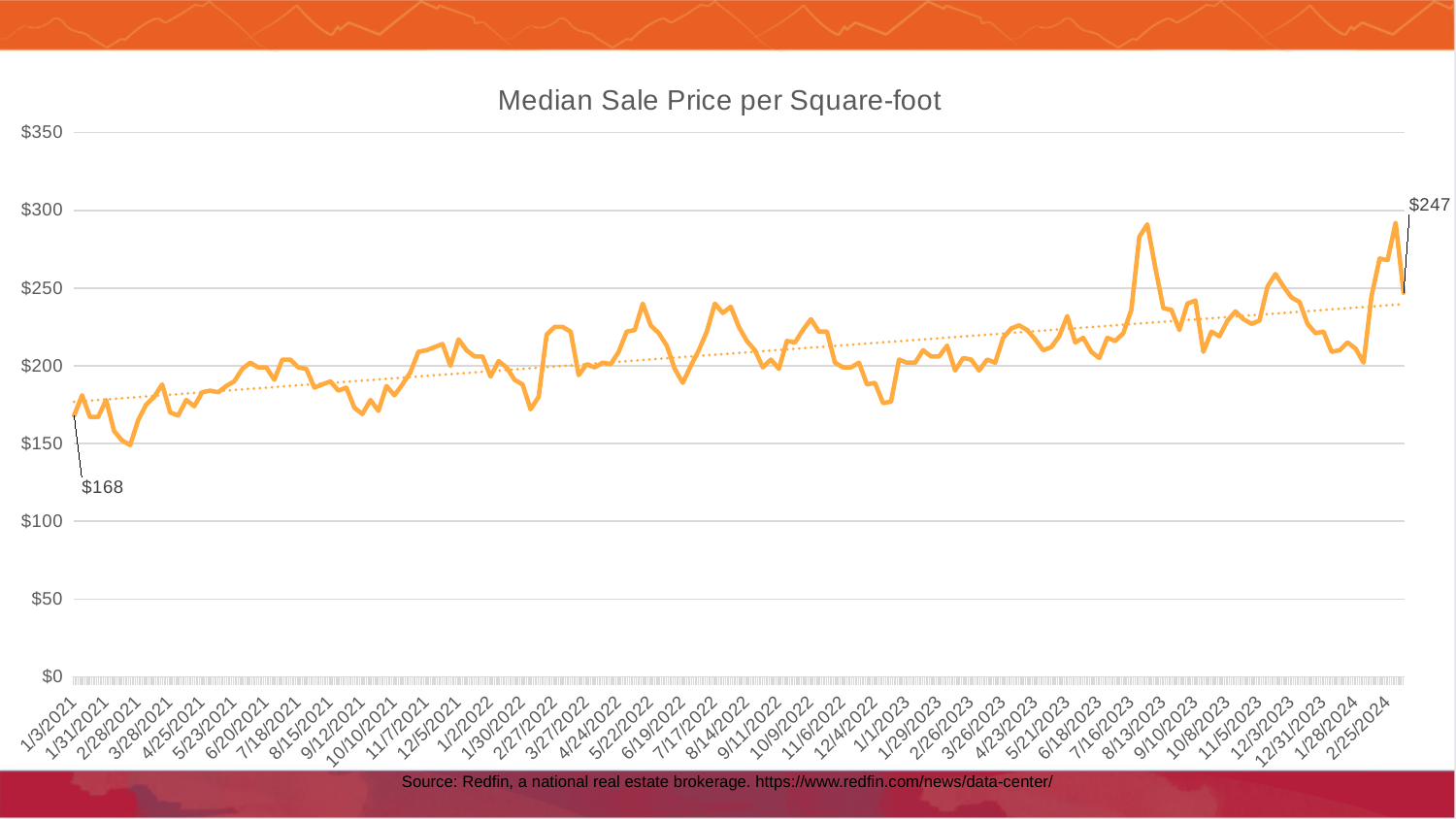
What is the highest value shown on the vertical axis? $350 Is the last labelled value in 2024 greater or less than $250? less What is the labelled value at the end of the line, in 2024? $247 Which is larger, the first labelled value on 1/3/2021 or the last labelled value in 2024? the last labelled value ($247) Overall, do the values rise or fall from 2021 to 2024? rise In which year does the lowest point of the line occur? 2021 What is the difference between the last labelled value ($247) and the first labelled value ($168)? $79 Is the first labelled value on 1/3/2021 greater or less than $150? greater What is the labelled value at the start of the line, on 1/3/2021? $168 Is the peak value around 7/16/2023 greater or less than $250? greater What kind of chart is shown on the slide? line chart What is the title of the chart? Median Sale Price per Square-foot